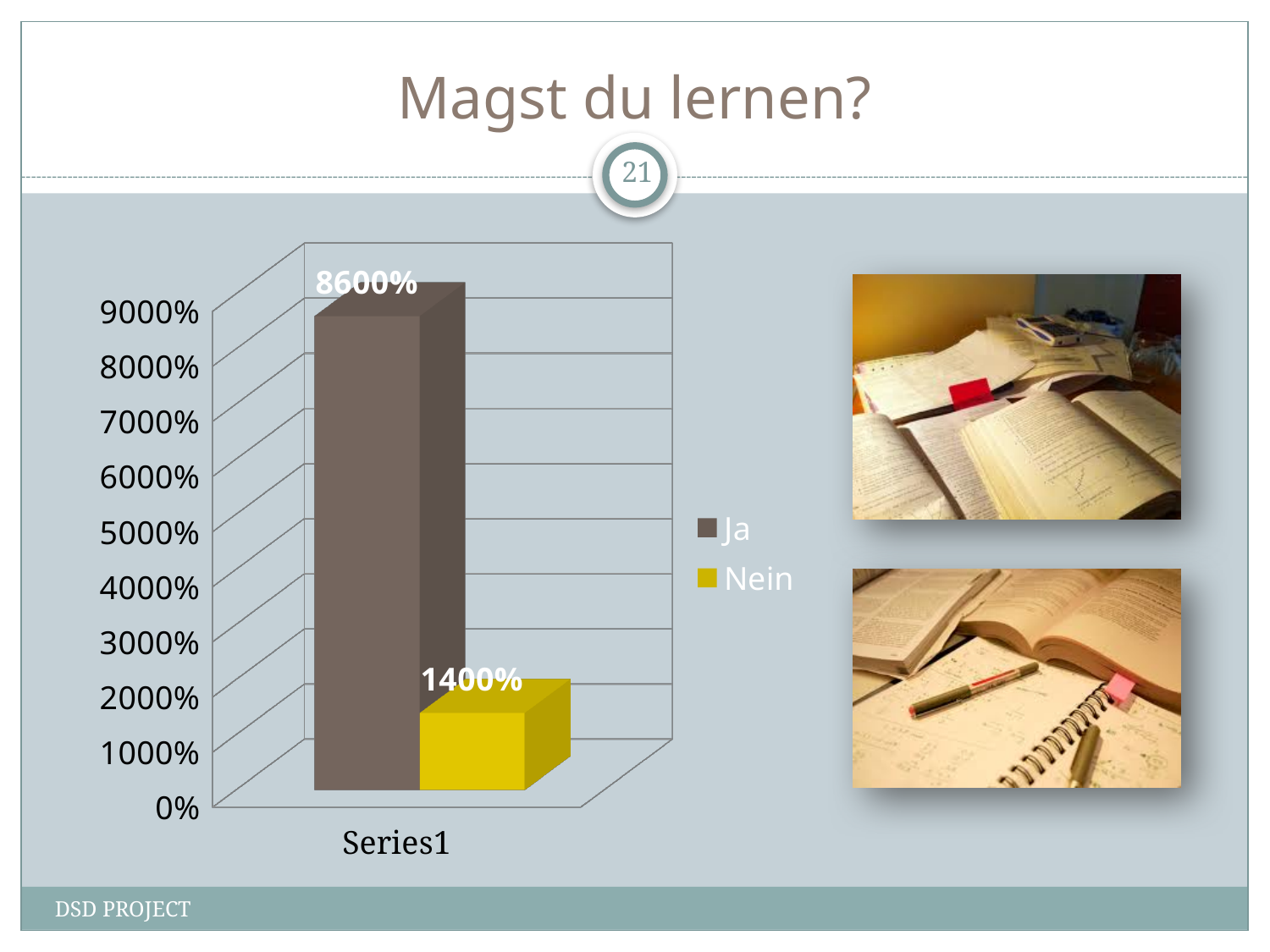
Which legend entry has the lowest value? Nein What is the value for Ja? 8600% Is the value for Nein greater or less than 2000%? less What is the category label shown on the x axis? Series1 What kind of chart is shown on the slide? bar chart Is the value for Ja greater or less than 8000%? greater Which is larger, the value for Ja or the value for Nein? Ja Which legend entry has the highest value? Ja What is the difference between the values for Ja and Nein? 7200% What is the value for Nein? 1400% How many series does the legend list? 2 What colour is the bar for Nein? yellow